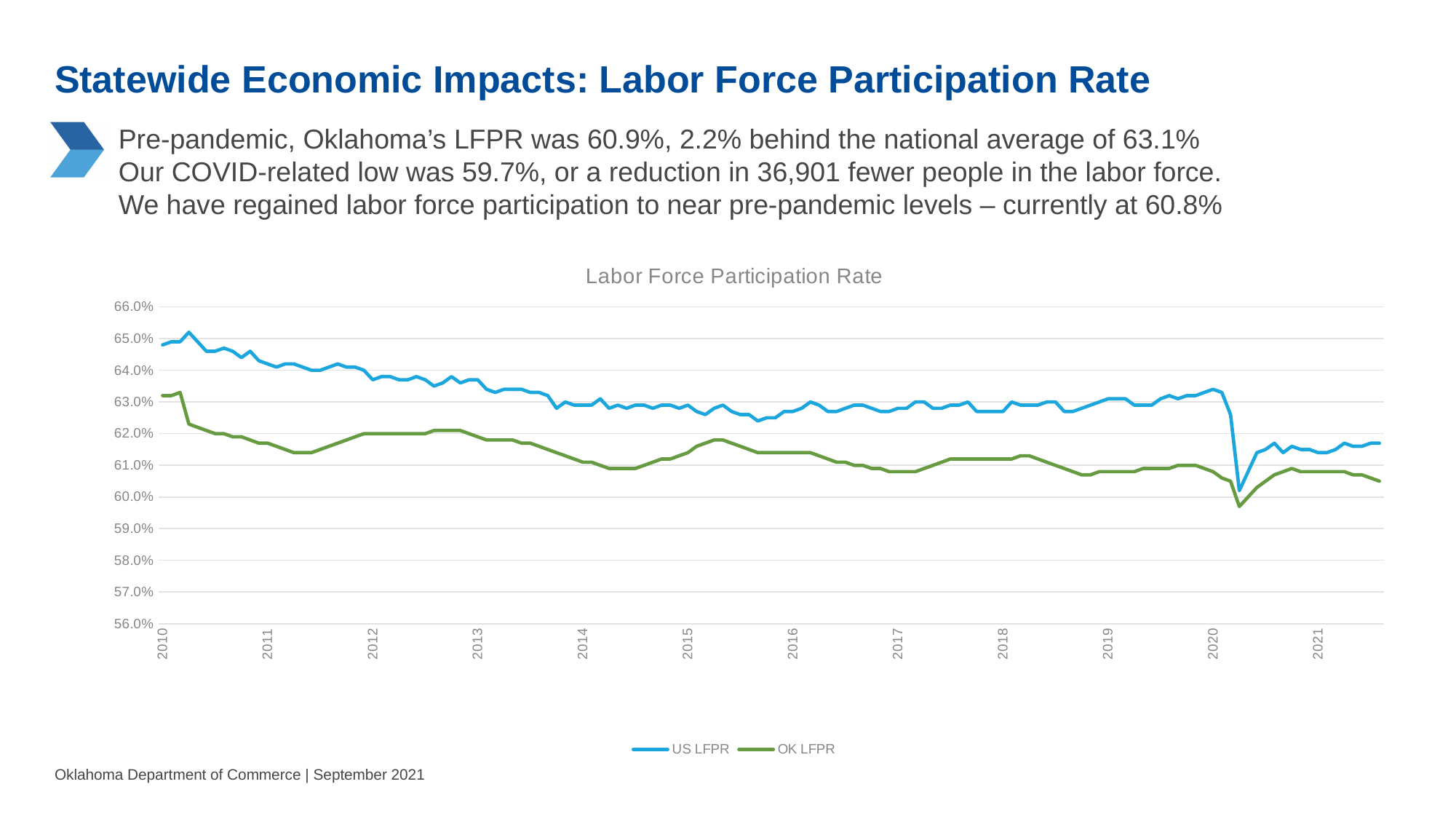
Is the value for OK LFPR at the start of 2014 greater or less than 62.0%? less Which two series are listed in the chart's legend? US LFPR and OK LFPR How many year labels are shown along the x axis of the chart? 12 How many series does the legend of the chart list? 2 Is the value for US LFPR at the start of 2010 greater or less than 64.0%? greater Which series reaches the highest value on the chart? US LFPR What is the title of the chart? Labor Force Participation Rate Does the US LFPR line generally rise or fall from 2010 to 2019? fall Which series reaches the lowest value on the chart? OK LFPR Is the lowest value for US LFPR in 2020 greater or less than 61.0%? less What kind of chart is shown on the slide? line chart Which series is higher in 2015, US LFPR or OK LFPR? US LFPR